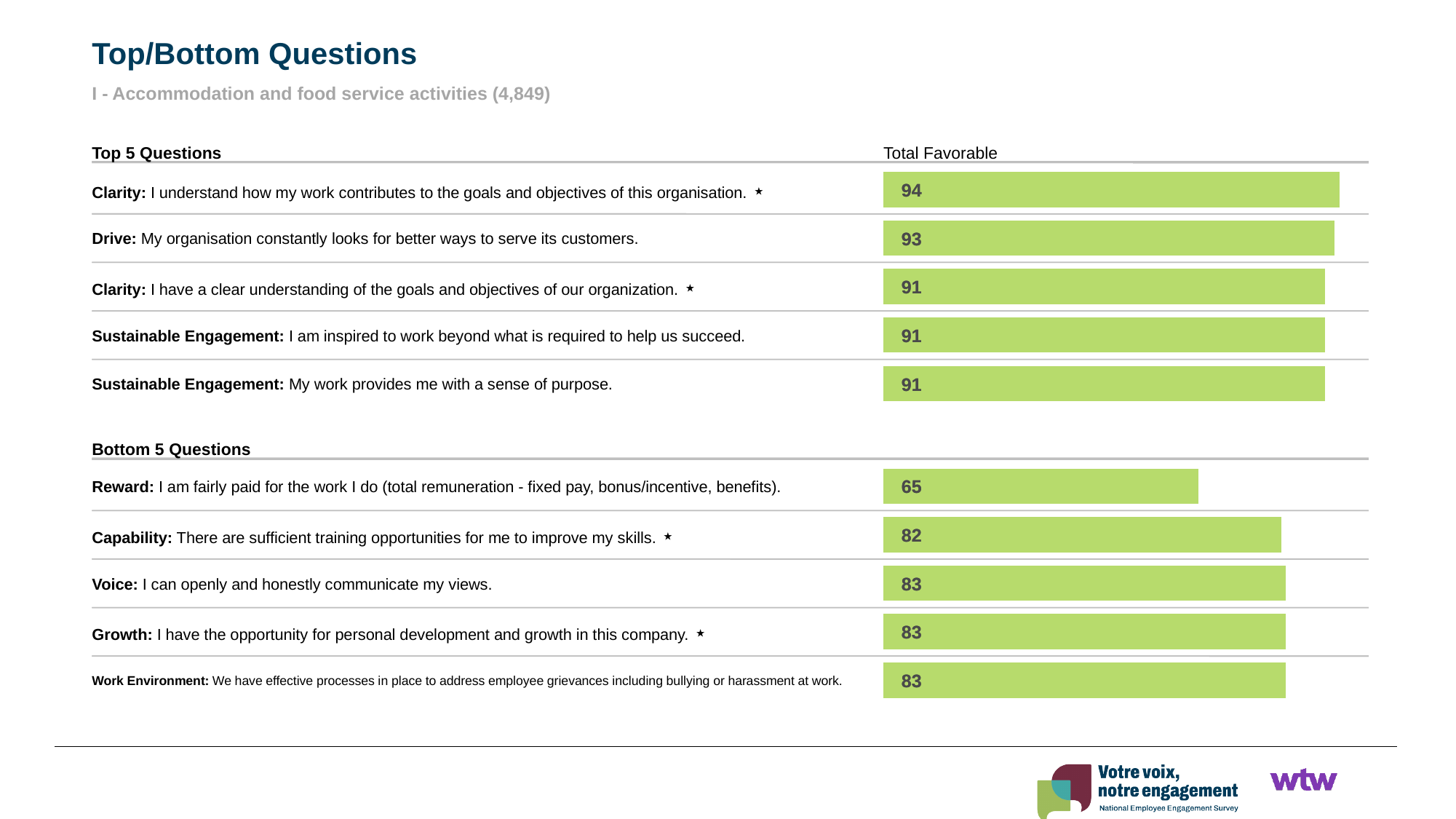
What kind of chart is used to show the Total Favorable values on this slide? Bar chart In the Bottom 5 Questions chart, what is the Total Favorable value for "Capability: There are sufficient training opportunities for me to improve my skills."? 82 What is the title of the slide containing the Top 5 and Bottom 5 Questions charts? Top/Bottom Questions In the Bottom 5 Questions chart, what is the Total Favorable value for "Reward: I am fairly paid for the work I do"? 65 In the Top 5 Questions chart, what is the Total Favorable value for "Sustainable Engagement: My work provides me with a sense of purpose."? 91 How many questions are shown in the Bottom 5 Questions chart? 5 In the Bottom 5 Questions chart, what is the difference between the Total Favorable values for the Voice question and the Reward question? 18 In the Top 5 Questions chart, what is the difference between the Total Favorable values for the first Clarity question (94) and the Drive question? 1 In the Top 5 Questions chart, which question has the highest Total Favorable value? Clarity: I understand how my work contributes to the goals and objectives of this organisation. In the Bottom 5 Questions chart, which question has the lowest Total Favorable value? Reward: I am fairly paid for the work I do (total remuneration - fixed pay, bonus/incentive, benefits). Which has a higher Total Favorable value: the Drive question in the Top 5 chart or the Growth question in the Bottom 5 chart? Drive question In the Top 5 Questions chart, what is the Total Favorable value for "Drive: My organisation constantly looks for better ways to serve its customers."? 93